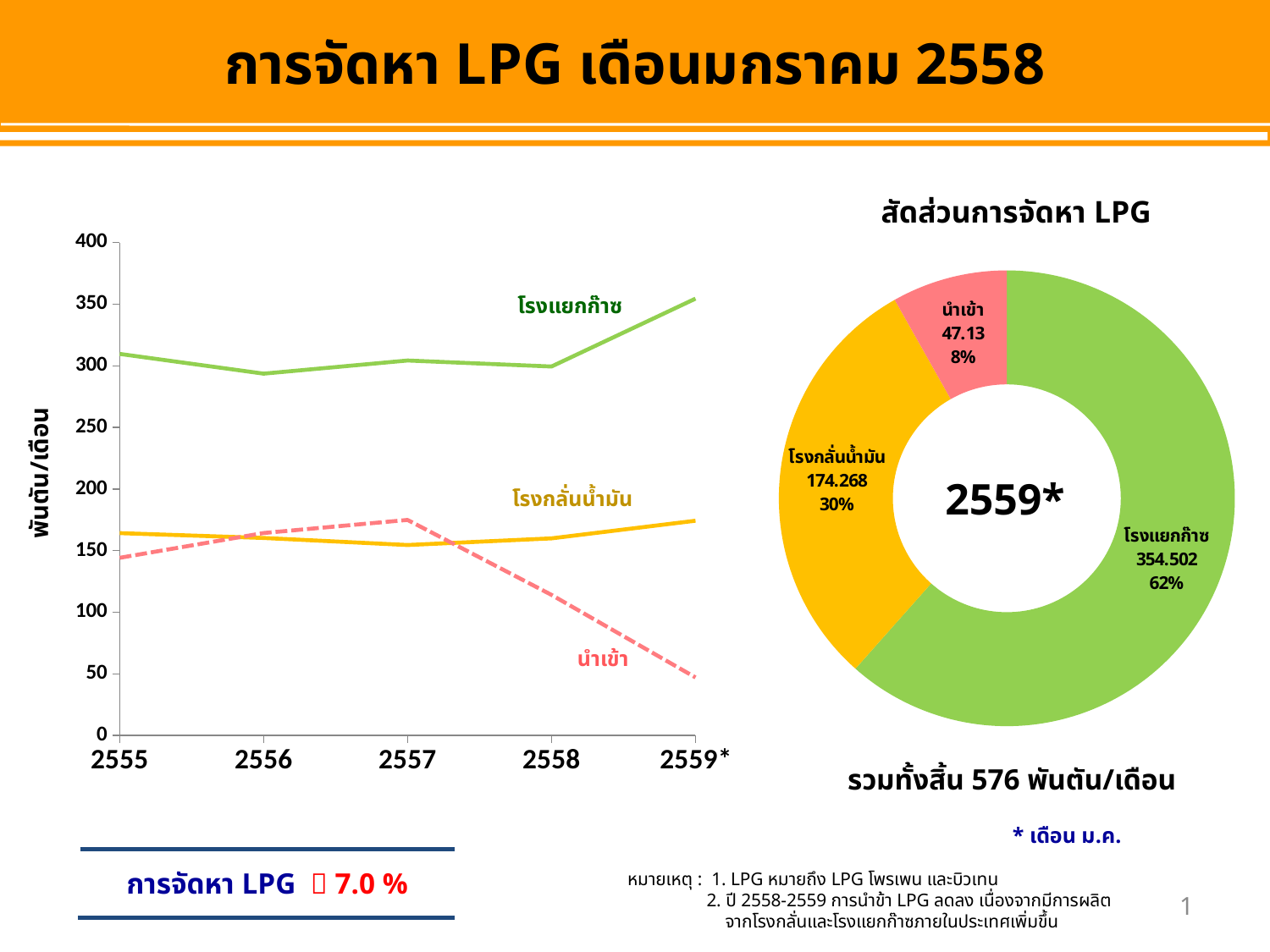
In the doughnut chart titled สัดส่วนการจัดหา LPG, what is the value for โรงแยกก๊าซ? 354.502 What kind of chart is the chart on the left of the slide? Line chart In the doughnut chart titled สัดส่วนการจัดหา LPG, how many categories are shown? 3 In the doughnut chart titled สัดส่วนการจัดหา LPG, what is the difference between the values for โรงแยกก๊าซ and โรงกลั่นน้ำมัน? 180.234 What kind of chart is the chart on the right of the slide? Doughnut chart In the line chart on the left, does the value for นำเข้า rise or fall from 2557 to 2559*? fall In the doughnut chart titled สัดส่วนการจัดหา LPG, which category has the largest share? โรงแยกก๊าซ In the doughnut chart titled สัดส่วนการจัดหา LPG, what is the value for นำเข้า? 47.13 In the doughnut chart titled สัดส่วนการจัดหา LPG, which category has the smallest share? นำเข้า In the doughnut chart titled สัดส่วนการจัดหา LPG, what share does โรงกลั่นน้ำมัน have? 30% In the line chart on the left, is the value for โรงแยกก๊าซ in 2559* greater or less than 300? greater In the line chart on the left, how many years are shown on the x axis? 5